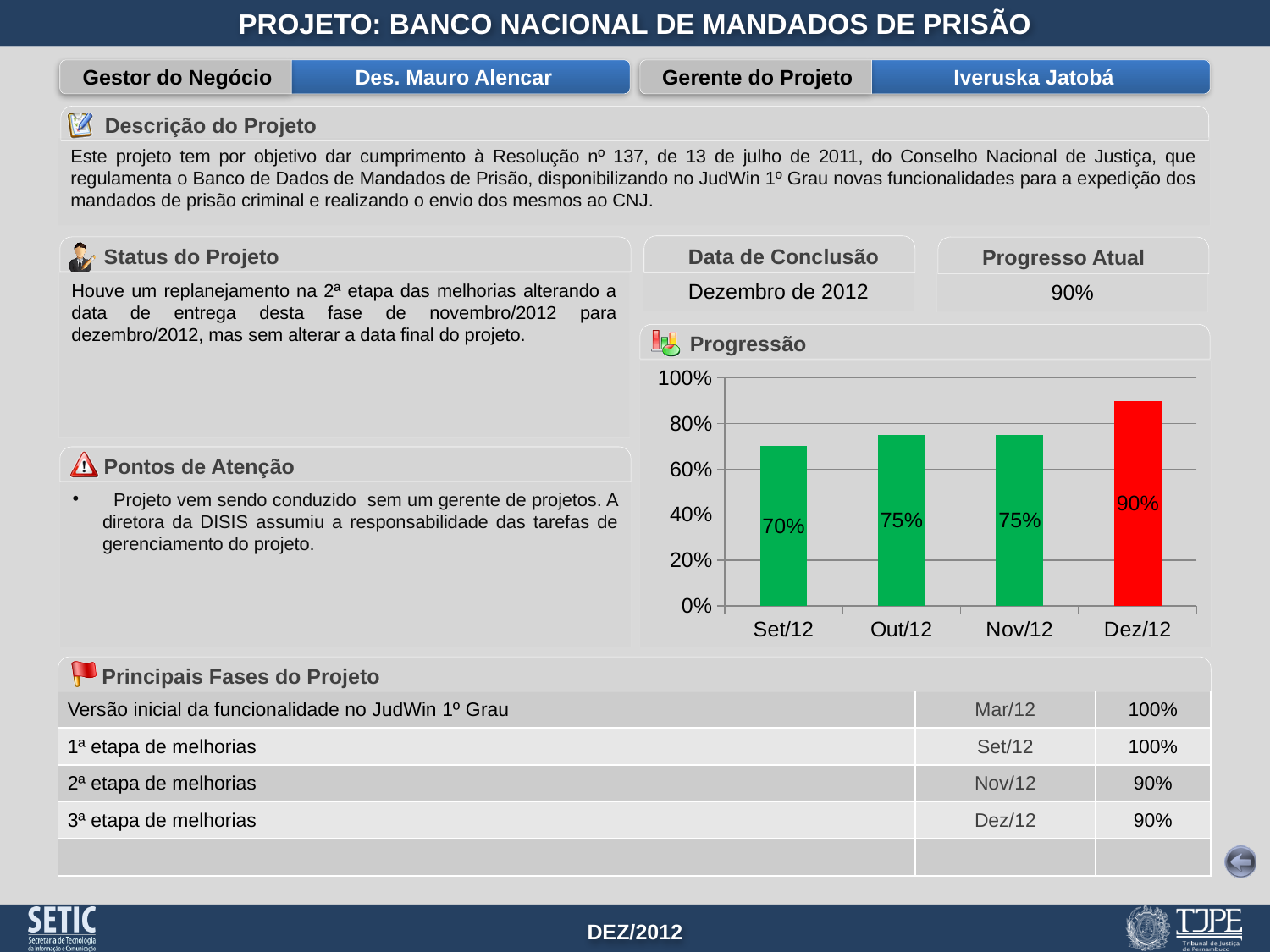
What is the difference between the values for Dez/12 and Set/12 in the Progressão chart? 20% What colour is the Dez/12 bar in the Progressão chart? red How many months are shown on the x axis of the Progressão chart? 4 What is the value for Set/12 in the Progressão chart? 70% Do the values in the Progressão chart rise or fall from Set/12 to Dez/12? rise What kind of chart is the Progressão chart? bar chart Which month has the highest value in the Progressão chart? Dez/12 What is the value for Out/12 in the Progressão chart? 75% Which month has the lowest value in the Progressão chart? Set/12 What is the difference between the values for Out/12 and Set/12 in the Progressão chart? 5% Which is larger in the Progressão chart, the value for Nov/12 or the value for Dez/12? Dez/12 What is the value for Dez/12 in the Progressão chart? 90%